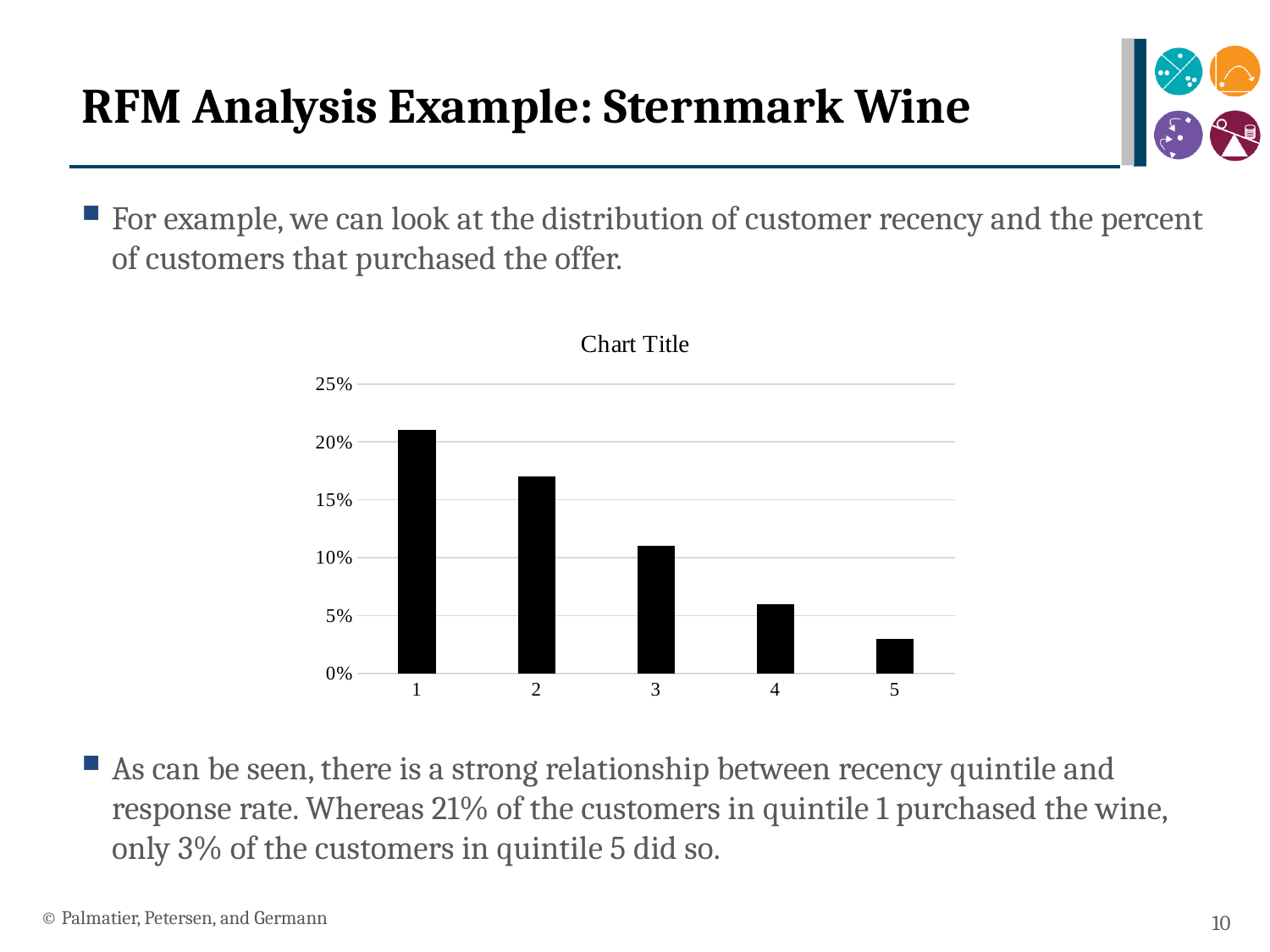
Do the bar values rise or fall as the quintile number increases from 1 to 5? fall What kind of chart is shown on the slide? bar chart Is the value for quintile 5 greater or less than 5%? less Which has the larger value, quintile 2 or quintile 4? quintile 2 Is the value for quintile 2 greater or less than 15%? greater Is the value for quintile 2 greater or less than 20%? less According to the slide, what percent of customers in quintile 1 purchased the wine? 21% How many categories (quintiles) are shown on the x axis of the chart? 5 Which quintile has the highest bar in the chart? 1 What is the title shown above the chart? Chart Title Which quintile has the lowest bar in the chart? 5